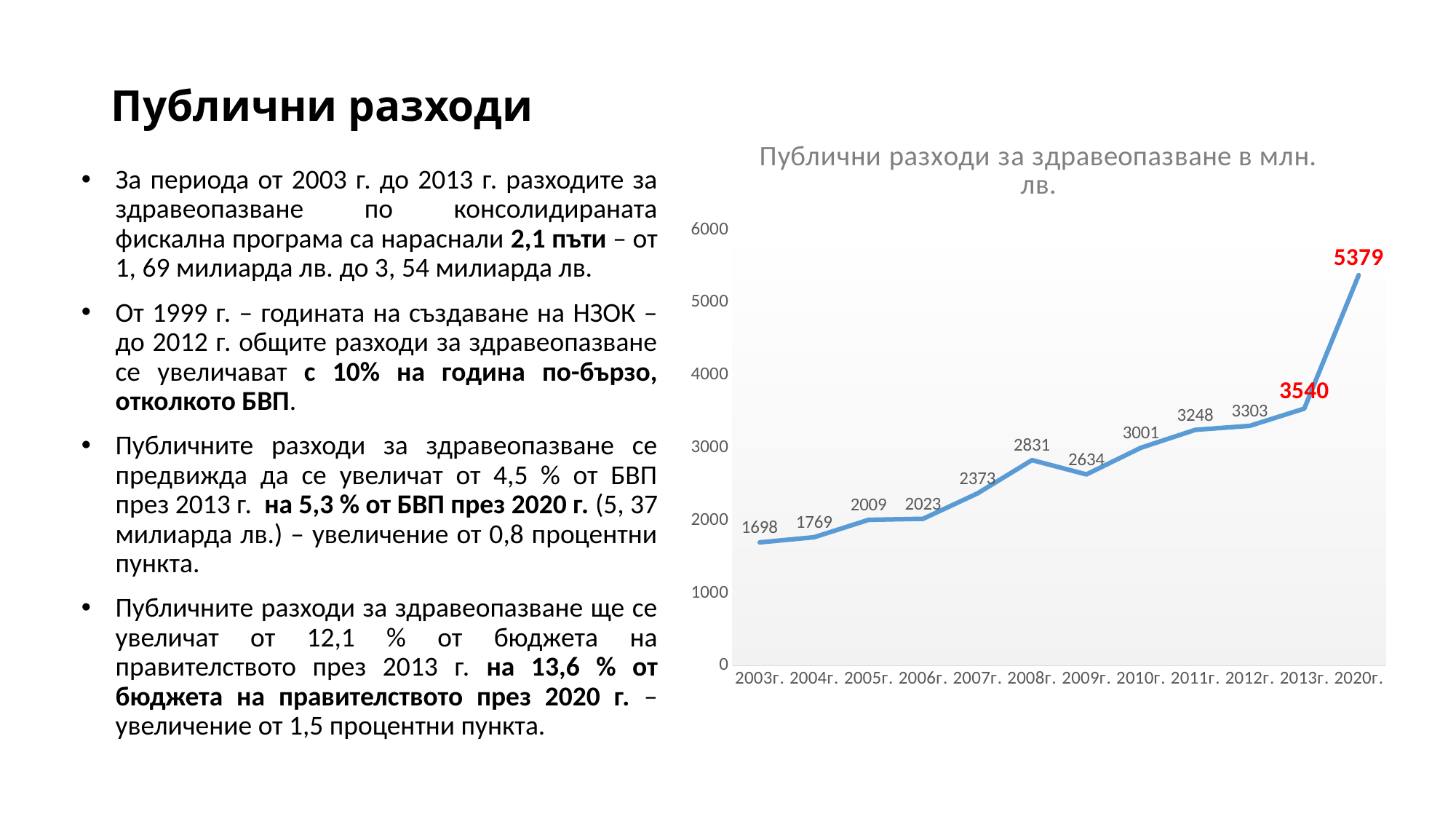
What is the value for 2020г. in the chart? 5379 What is the value for 2008г. in the chart? 2831 How many data points are plotted in the chart? 12 Is the value for 2011г. greater or less than 3000? greater What is the value for 2013г. in the chart? 3540 What kind of chart is shown on the slide? line chart What is the title of the chart? Публични разходи за здравеопазване в млн. лв. What is the difference between the values for 2020г. and 2013г.? 1839 Which year has the lowest value in the chart? 2003г. Which year has the highest value in the chart? 2020г. Which is larger, the value for 2008г. or the value for 2009г.? 2008г. What is the difference between the values for 2008г. and 2009г.? 197